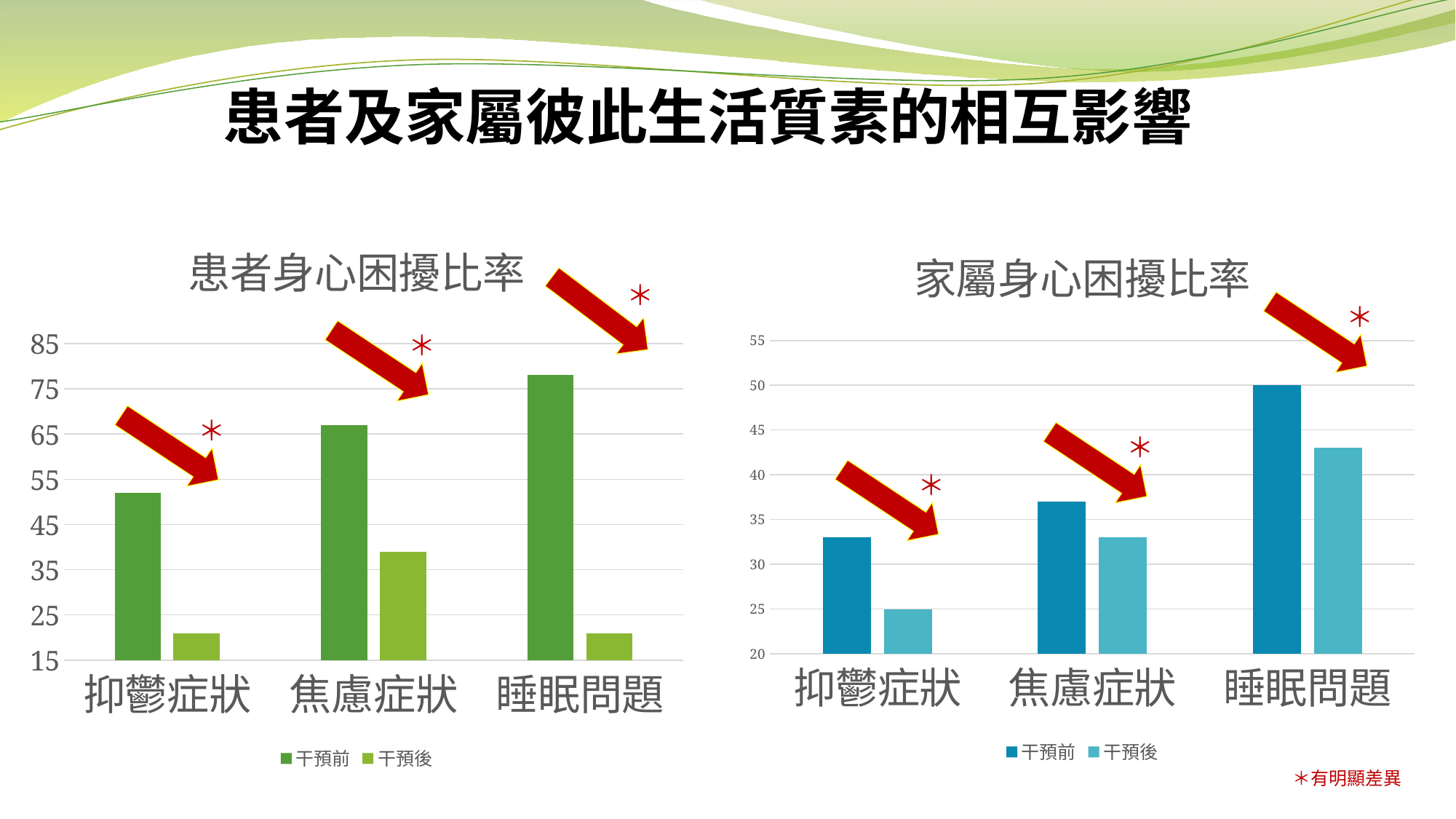
What are the two legend entries of the left chart titled 患者身心困擾比率? 干預前 and 干預後 In the right chart titled 家屬身心困擾比率, what is the 干預前 value for 睡眠問題? 50 In the left chart titled 患者身心困擾比率, is the 干預前 value for 焦慮症狀 greater or less than 65? greater In the left chart titled 患者身心困擾比率, is the 干預後 value for 睡眠問題 greater or less than 25? less In the left chart titled 患者身心困擾比率, do the 干預前 values rise or fall from 抑鬱症狀 to 睡眠問題? rise In the right chart titled 家屬身心困擾比率, which category has the lowest 干預後 value? 抑鬱症狀 How many series does the legend of the right chart titled 家屬身心困擾比率 list? 2 How many categories are shown on the x axis of the left chart titled 患者身心困擾比率? 3 In the left chart titled 患者身心困擾比率, which category has the highest 干預前 value? 睡眠問題 In the right chart titled 家屬身心困擾比率, which is larger for 焦慮症狀: the 干預前 value or the 干預後 value? 干預前 What kind of chart is the left chart titled 患者身心困擾比率? bar chart In the right chart titled 家屬身心困擾比率, is the 干預前 value for 抑鬱症狀 greater or less than 30? greater